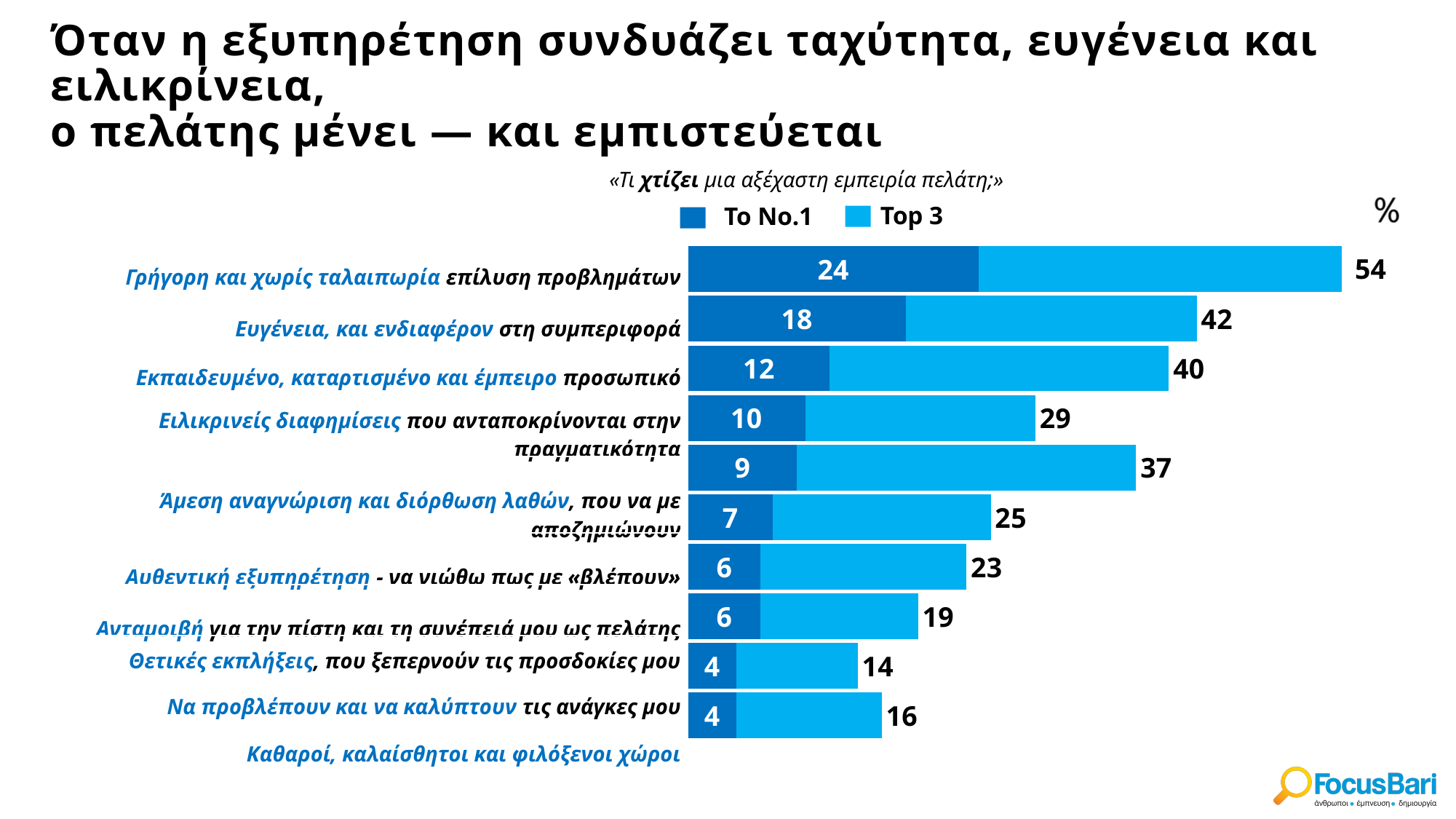
What is the Top 3 value for 'Γρήγορη και χωρίς ταλαιπωρία επίλυση προβλημάτων'? 54 What is the Top 3 value for 'Ευγένεια, και ενδιαφέρον στη συμπεριφορά'? 42 Which category has the highest Top 3 value? Γρήγορη και χωρίς ταλαιπωρία επίλυση προβλημάτων What is the 'Το No.1' value for 'Γρήγορη και χωρίς ταλαιπωρία επίλυση προβλημάτων'? 24 How many series does the legend list? 2 What are the two series named in the legend? Το No.1 and Top 3 What is the difference between the 'Το No.1' values for 'Ευγένεια, και ενδιαφέρον στη συμπεριφορά' and 'Εκπαιδευμένο, καταρτισμένο και έμπειρο προσωπικό'? 6 Which has the larger Top 3 value: 'Ευγένεια, και ενδιαφέρον στη συμπεριφορά' or 'Εκπαιδευμένο, καταρτισμένο και έμπειρο προσωπικό'? Ευγένεια, και ενδιαφέρον στη συμπεριφορά What is the 'Το No.1' value for 'Εκπαιδευμένο, καταρτισμένο και έμπειρο προσωπικό'? 12 How many bars (categories) are plotted in the chart? 10 What kind of chart is shown on the slide? Bar chart What is the difference between the Top 3 values for 'Γρήγορη και χωρίς ταλαιπωρία επίλυση προβλημάτων' and 'Ευγένεια, και ενδιαφέρον στη συμπεριφορά'? 12